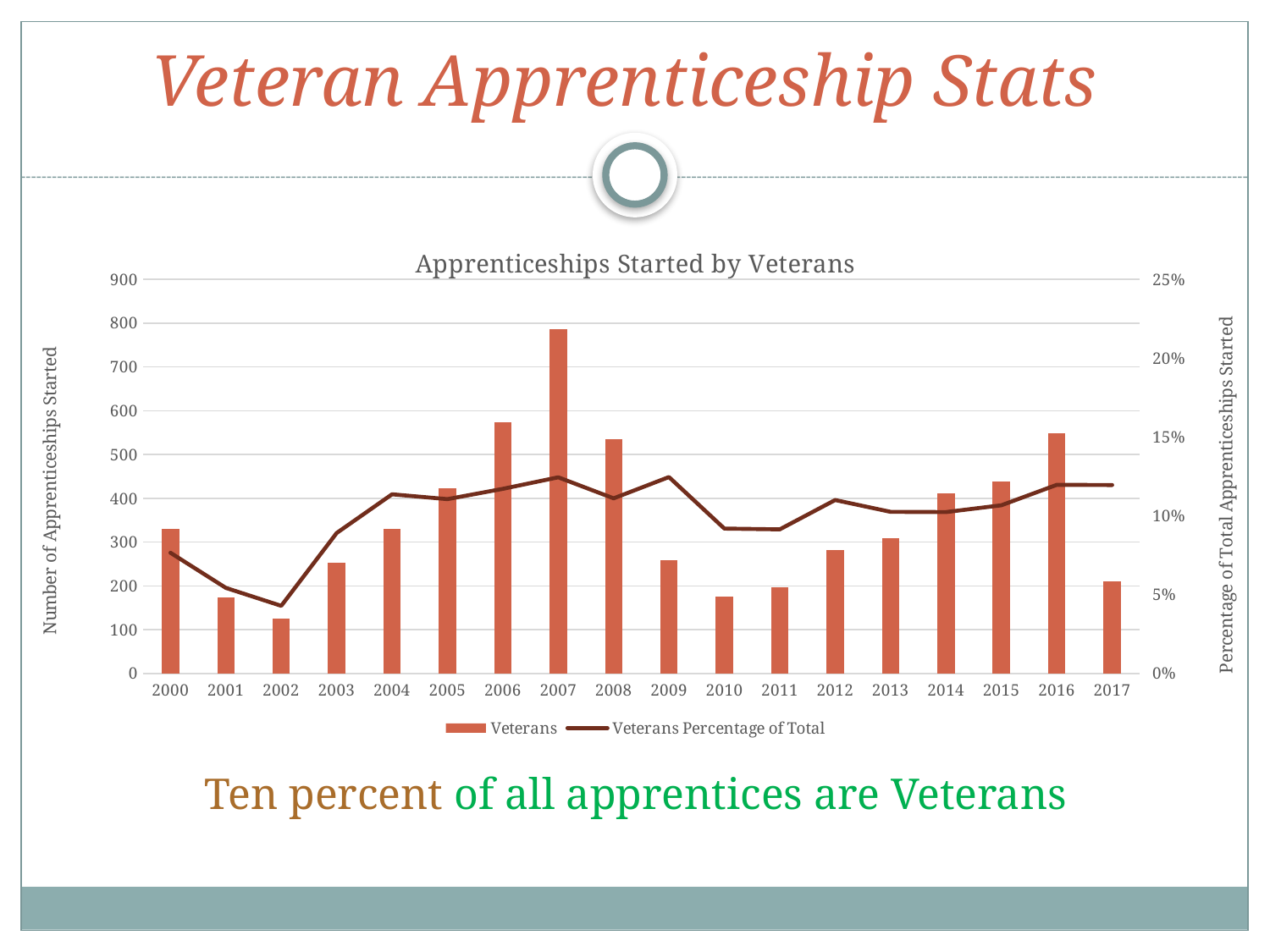
Which year has the lowest number of apprenticeships started by Veterans? 2002 Is the Veterans value for 2007 greater or less than 700? greater Is the Veterans value for 2002 greater or less than 200? less In which year is the Veterans Percentage of Total line at its lowest? 2002 Is the Veterans Percentage of Total for 2002 greater or less than 5%? less Which year has the highest number of apprenticeships started by Veterans? 2007 How many series does the legend list? 2 How many years are shown on the x axis? 18 Which year has a higher Veterans bar, 2016 or 2017? 2016 What kind of chart is used for the Veterans series? Bar chart What is the title of the chart? Apprenticeships Started by Veterans